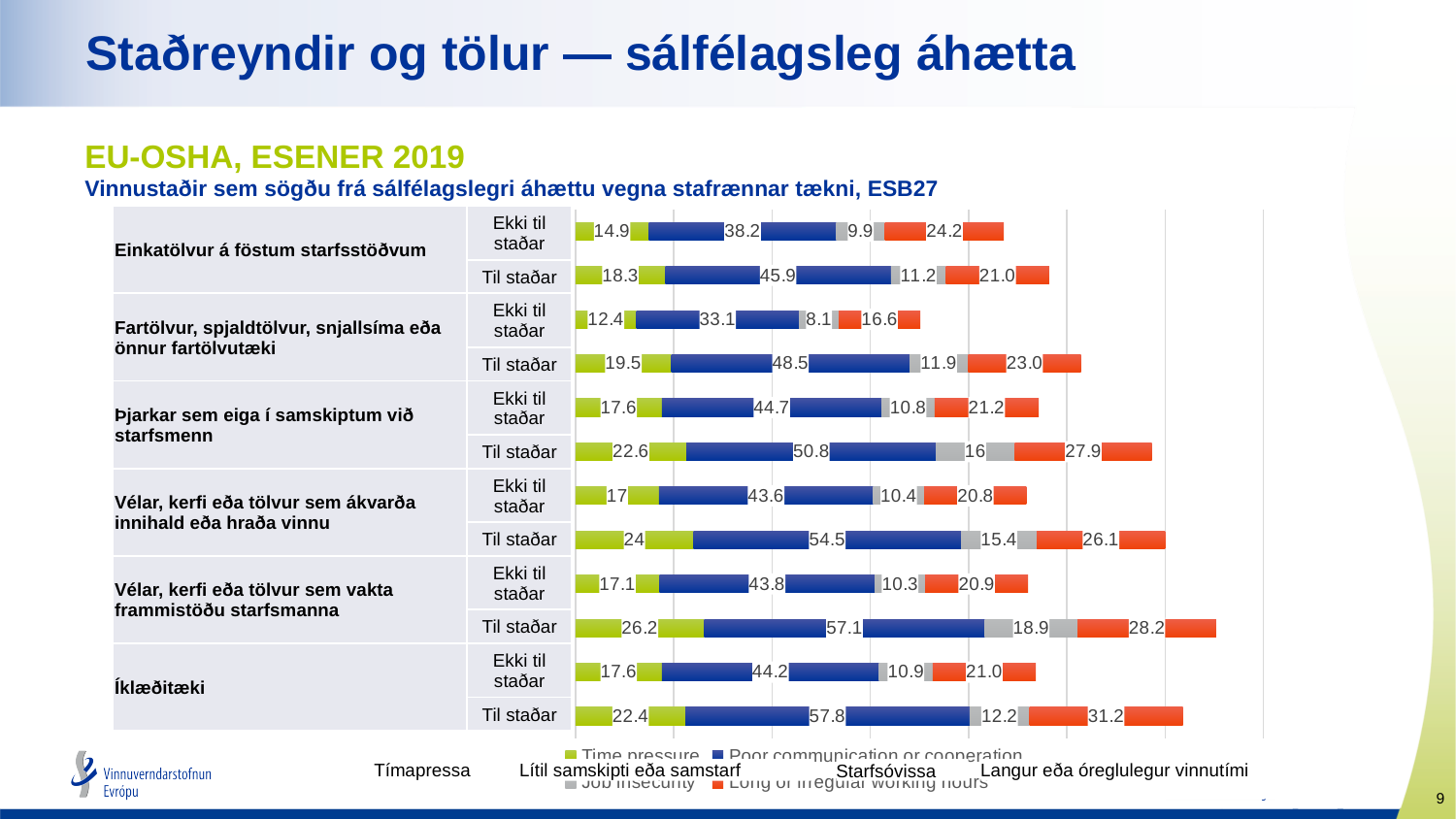
What is the value for Langur eða óreglulegur vinnutími for Íklæðitæki, Til staðar? 31.2 What is the value for Starfsóvissa for Fartölvur, spjaldtölvur, snjallsíma eða önnur fartölvutæki, Ekki til staðar? 8.1 How many series does the legend list? 4 How many bars are plotted in the chart? 12 Which bar has the highest value for Tímapressa? Vélar, kerfi eða tölvur sem vakta frammistöðu starfsmanna, Til staðar What is the difference in Lítil samskipti eða samstarf between Til staðar and Ekki til staðar for Einkatölvur á föstum starfsstöðvum? 7.7 What kind of chart is shown on the slide? Stacked bar chart What is the value for Lítil samskipti eða samstarf for Einkatölvur á föstum starfsstöðvum, Til staðar? 45.9 Which bar has the lowest value for Lítil samskipti eða samstarf? Fartölvur, spjaldtölvur, snjallsíma eða önnur fartölvutæki, Ekki til staðar What is the value for Tímapressa for Vélar, kerfi eða tölvur sem vakta frammistöðu starfsmanna, Til staðar? 26.2 What is the total of the stacked bar for Fartölvur, spjaldtölvur, snjallsíma eða önnur fartölvutæki, Ekki til staðar? 70.2 Which is larger: Langur eða óreglulegur vinnutími for Þjarkar sem eiga í samskiptum við starfsmenn, Til staðar, or for Íklæðitæki, Til staðar? Íklæðitæki, Til staðar